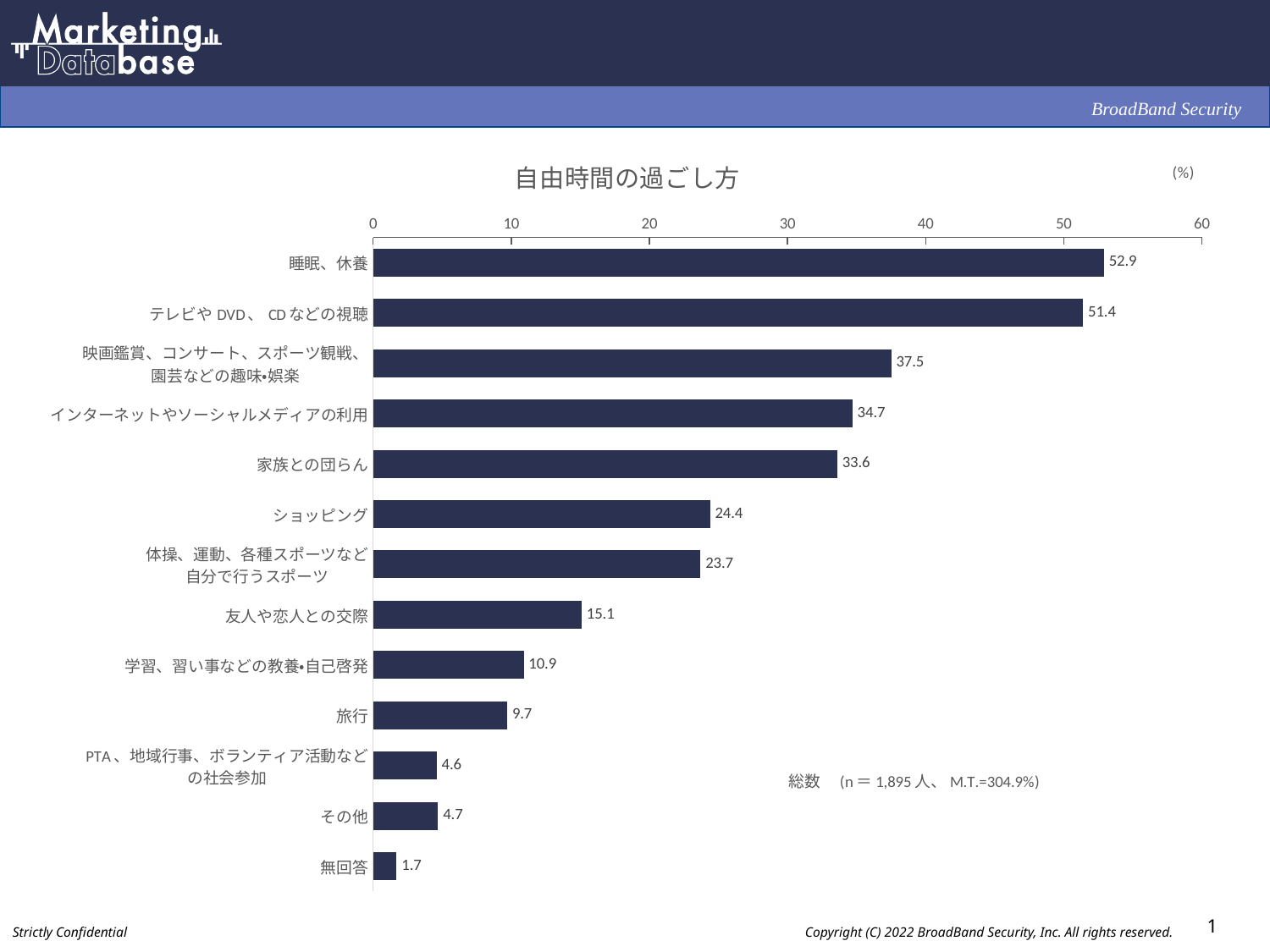
What kind of chart is shown on the slide? bar chart Which category has the highest value? 睡眠、休養 What is the title of the chart? 自由時間の過ごし方 What is the value for インターネットやソーシャルメディアの利用? 34.7 What is the difference between 睡眠、休養 and テレビやDVD、CDなどの視聴? 1.5 What is the value for 旅行? 9.7 Which category has the lowest value? 無回答 Which is larger, その他 or PTA、地域行事、ボランティア活動などの社会参加? その他 What is the value for 無回答? 1.7 What is the value for 睡眠、休養? 52.9 How many categories are shown in the chart? 13 What is the difference between ショッピング and 体操、運動、各種スポーツなど自分で行うスポーツ? 0.7